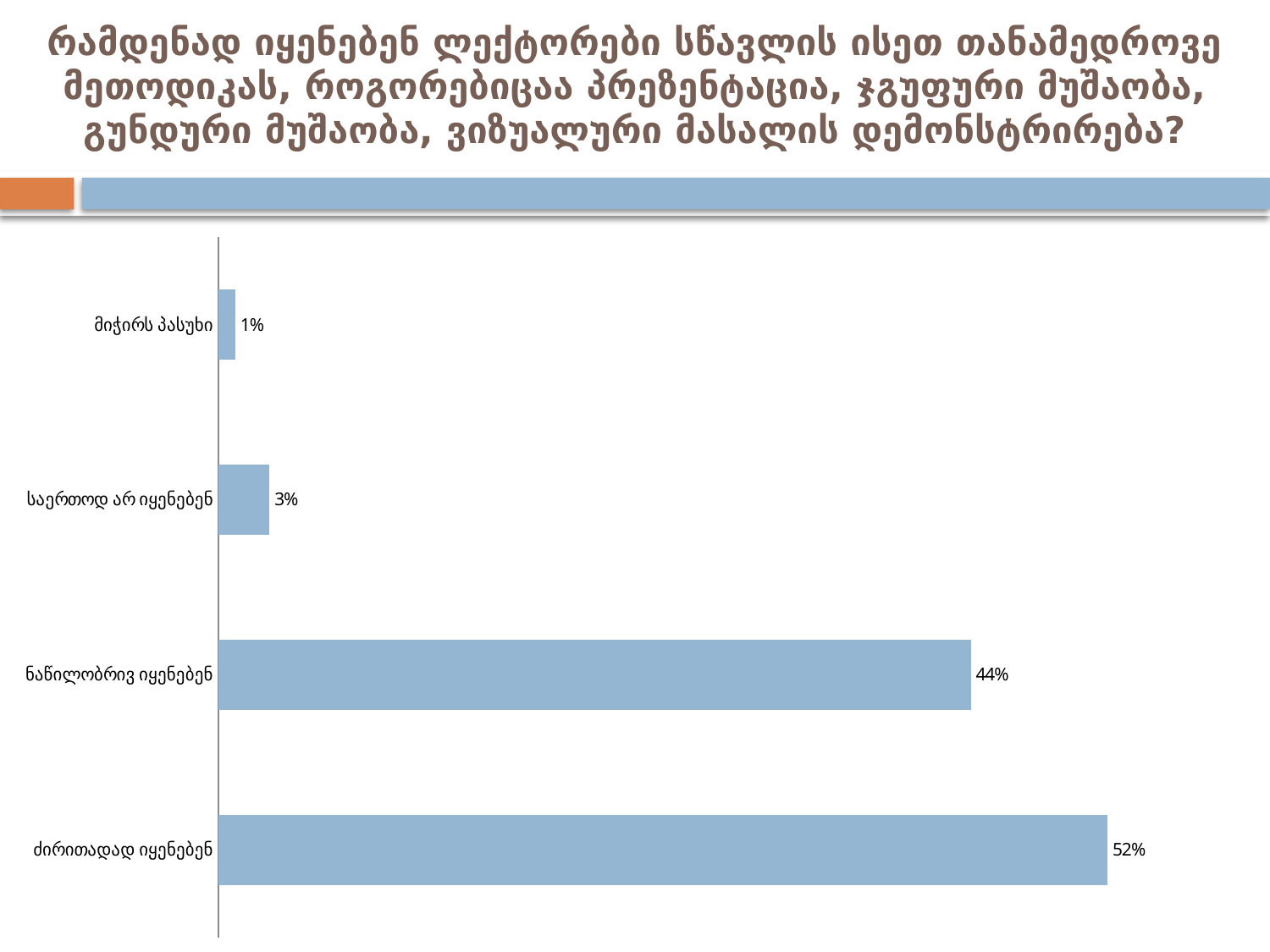
Which category has the highest value? ძირითადად იყენებენ What is the difference between the values for საერთოდ არ იყენებენ and მიჭირს პასუხი? 2% What value is shown for საერთოდ არ იყენებენ? 3% What colour are the bars in the chart? Light blue Which is larger, the value for ნაწილობრივ იყენებენ or the value for საერთოდ არ იყენებენ? ნაწილობრივ იყენებენ What kind of chart is shown on the slide? Bar chart What value is shown for ნაწილობრივ იყენებენ? 44% What value is shown for მიჭირს პასუხი? 1% What is the difference between the values for ძირითადად იყენებენ and ნაწილობრივ იყენებენ? 8% What value is shown for ძირითადად იყენებენ? 52% Which category has the lowest value? მიჭირს პასუხი How many categories are shown in the chart? 4